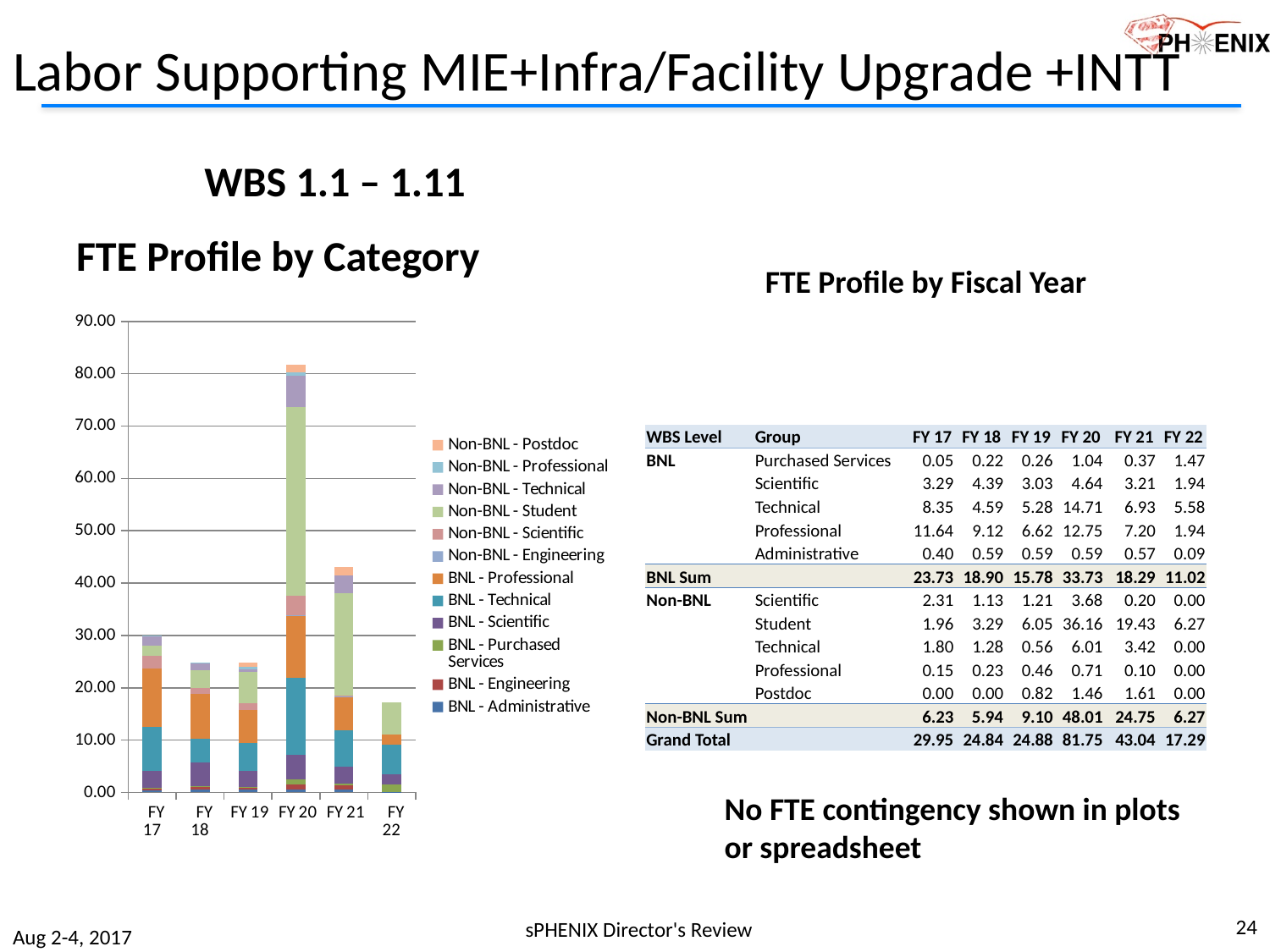
Is the total stacked bar for FY 20 greater or less than 70? greater How many series does the chart's legend list? 12 Which series is listed first (at the top) in the chart's legend? Non-BNL - Postdoc What is the title of the chart on the slide? FTE Profile by Category What kind of chart is shown on the slide? stacked bar chart Which stacked bar is taller, FY 21 or FY 17? FY 21 Is the total stacked bar for FY 18 greater or less than 30? less Which fiscal year has the tallest stacked bar in the chart? FY 20 How many fiscal years are shown on the x axis of the chart? 6 Which fiscal year has the shortest stacked bar in the chart? FY 22 Is the total stacked bar for FY 21 greater or less than 40? greater